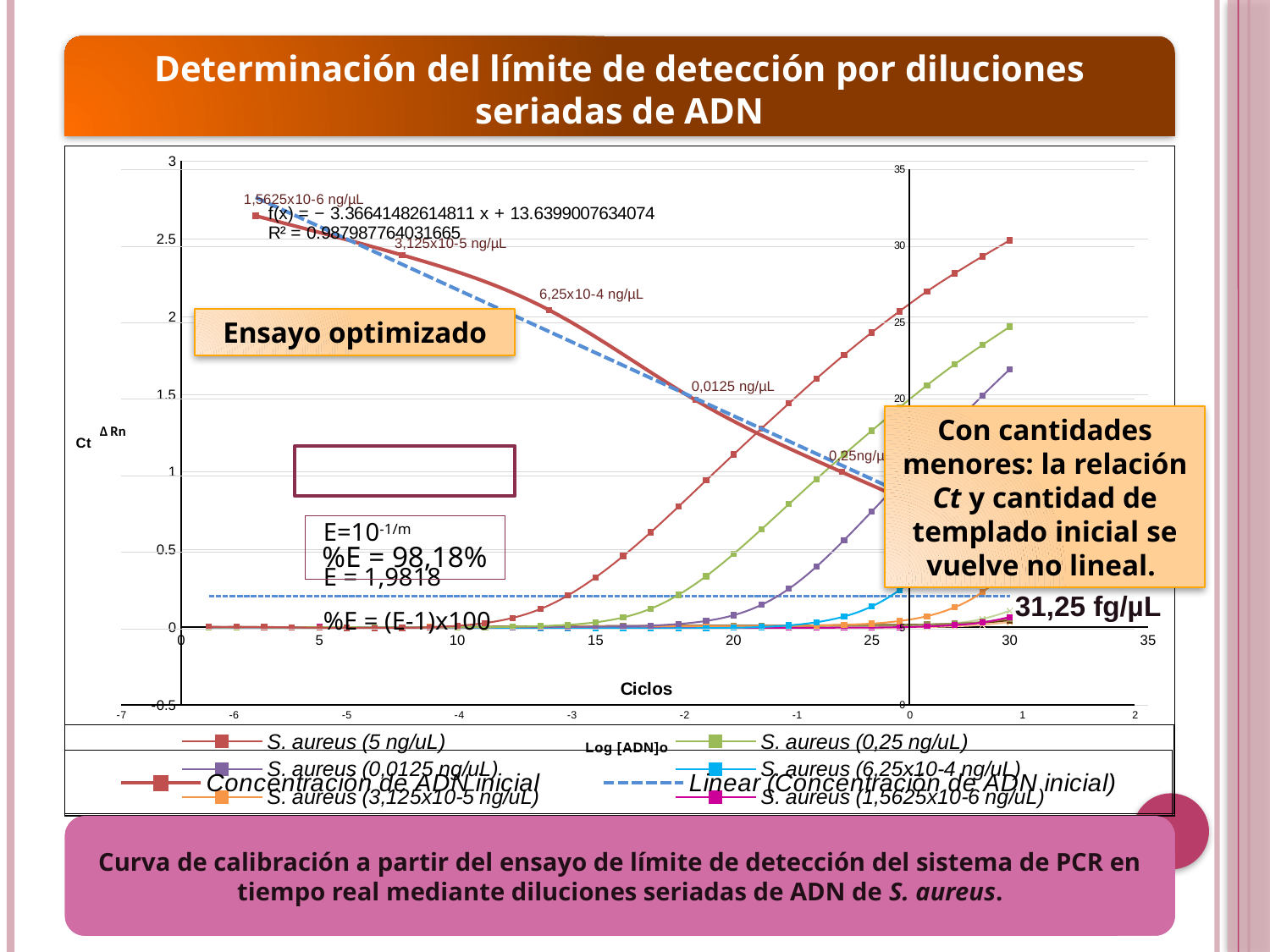
In the amplification chart (x axis Ciclos), which series reaches the highest value at cycle 30? S. aureus (5 ng/uL) How many series does the legend of the calibration chart (x axis Log [ADN]o) list? 2 In the calibration chart (x axis Log [ADN]o), does Ct rise or fall as Log [ADN]o increases? fall How many S. aureus series does the legend of the amplification chart (x axis Ciclos) list? 6 What is the slope of the fitted line f(x) shown on the calibration chart? −3.36641482614811 What R² value is printed on the calibration chart (x axis Log [ADN]o)? 0.987987764031665 What kind of chart is the amplification plot with the x axis labelled Ciclos? line chart In the amplification chart (x axis Ciclos), do the S. aureus curves rise or fall as the number of cycles increases? rise In the amplification chart (x axis Ciclos), which is higher at cycle 30: S. aureus (5 ng/uL) or S. aureus (0,25 ng/uL)? S. aureus (5 ng/uL) What is the x-axis title of the amplification chart? Ciclos